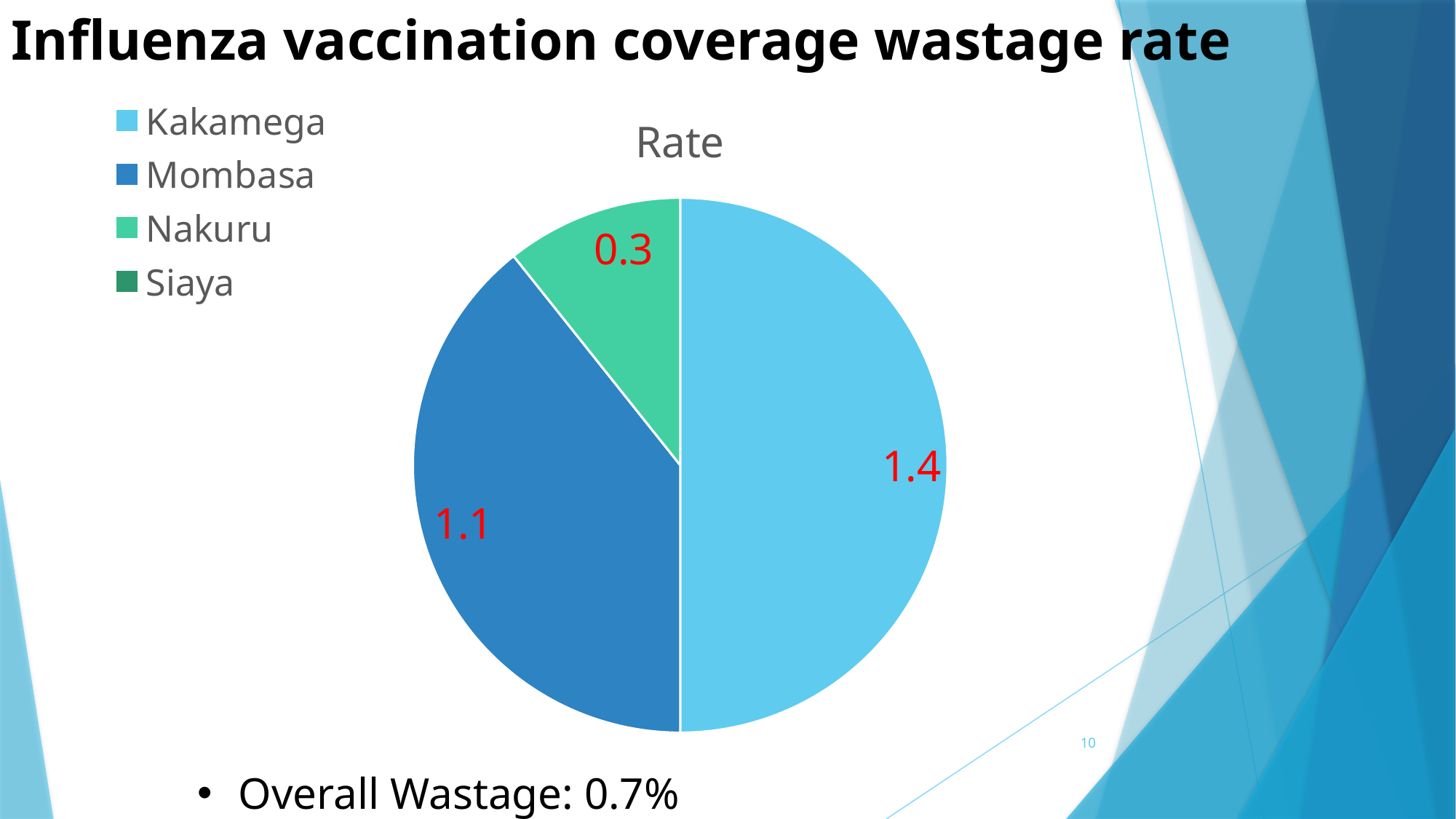
What is the title of the pie chart? Rate How many entries does the legend of the chart list? 4 What is the difference between the values for Kakamega and Mombasa? 0.3 What is the value shown for Kakamega in the pie chart? 1.4 What is the difference between the values for Mombasa and Nakuru? 0.8 Which of the labelled slices in the pie chart has the smallest value? Nakuru What kind of chart is shown on the slide? Pie chart What is the value shown for Nakuru in the pie chart? 0.3 Which is larger, the value for Mombasa or the value for Nakuru? Mombasa Which county has the largest slice in the pie chart? Kakamega What is the value shown for Mombasa in the pie chart? 1.1 What share of the pie does the Kakamega slice represent? 50%